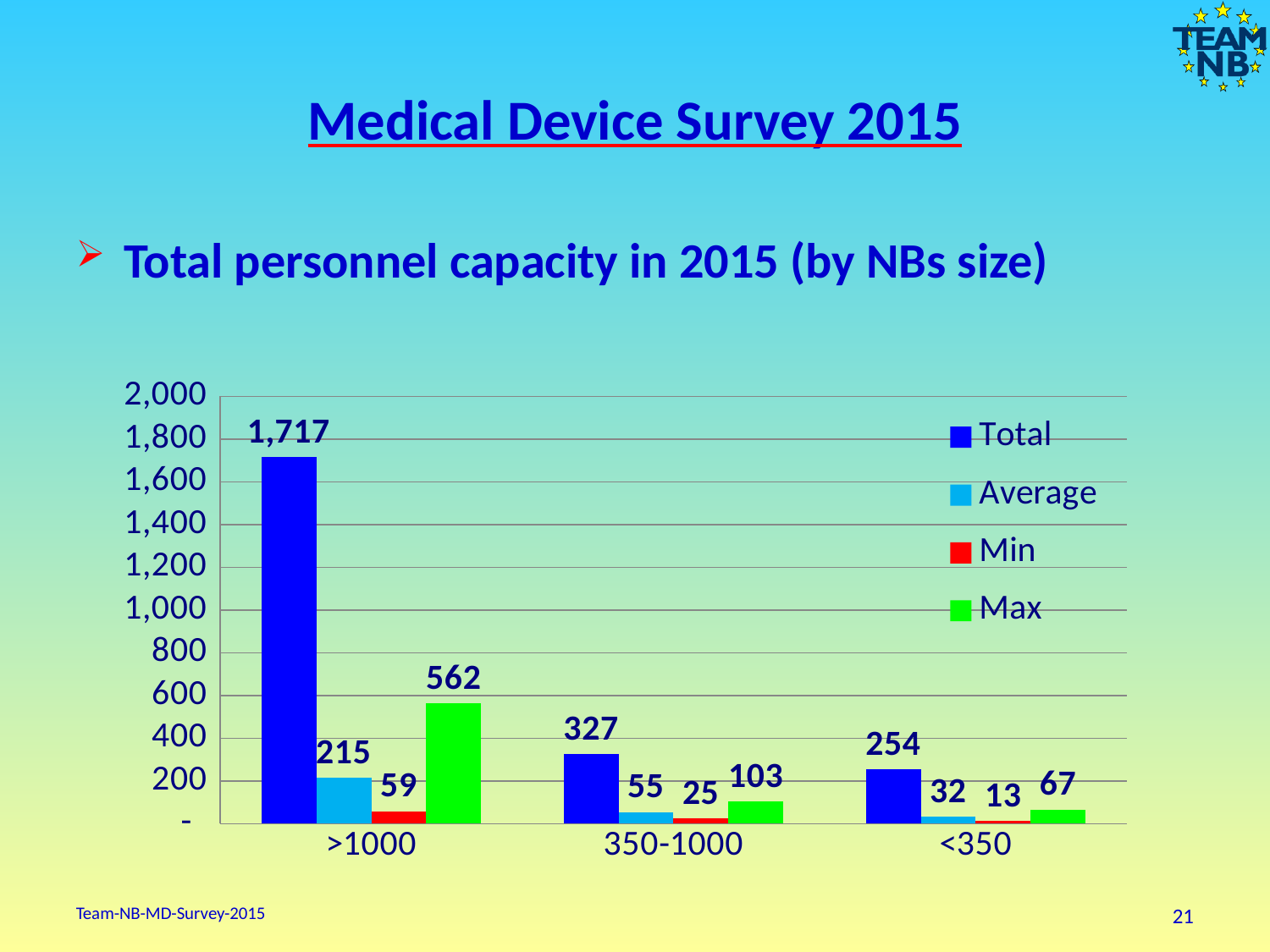
How many categories are shown on the x axis? 3 Which category has the highest Total value? >1000 Which category has the lowest Min value? <350 Which is larger, the Max value for >1000 or the Total value for 350-1000? Max value for >1000 What is the Max value for the 350-1000 category? 103 Do the Total values rise or fall from left to right along the x axis? Fall What is the Average value for the <350 category? 32 What kind of chart is shown on the slide? Bar chart What is the Total value for the >1000 category? 1,717 How many series does the legend list? 4 What is the difference between the Total values for 350-1000 and <350? 73 What is the Min value for the 350-1000 category? 25